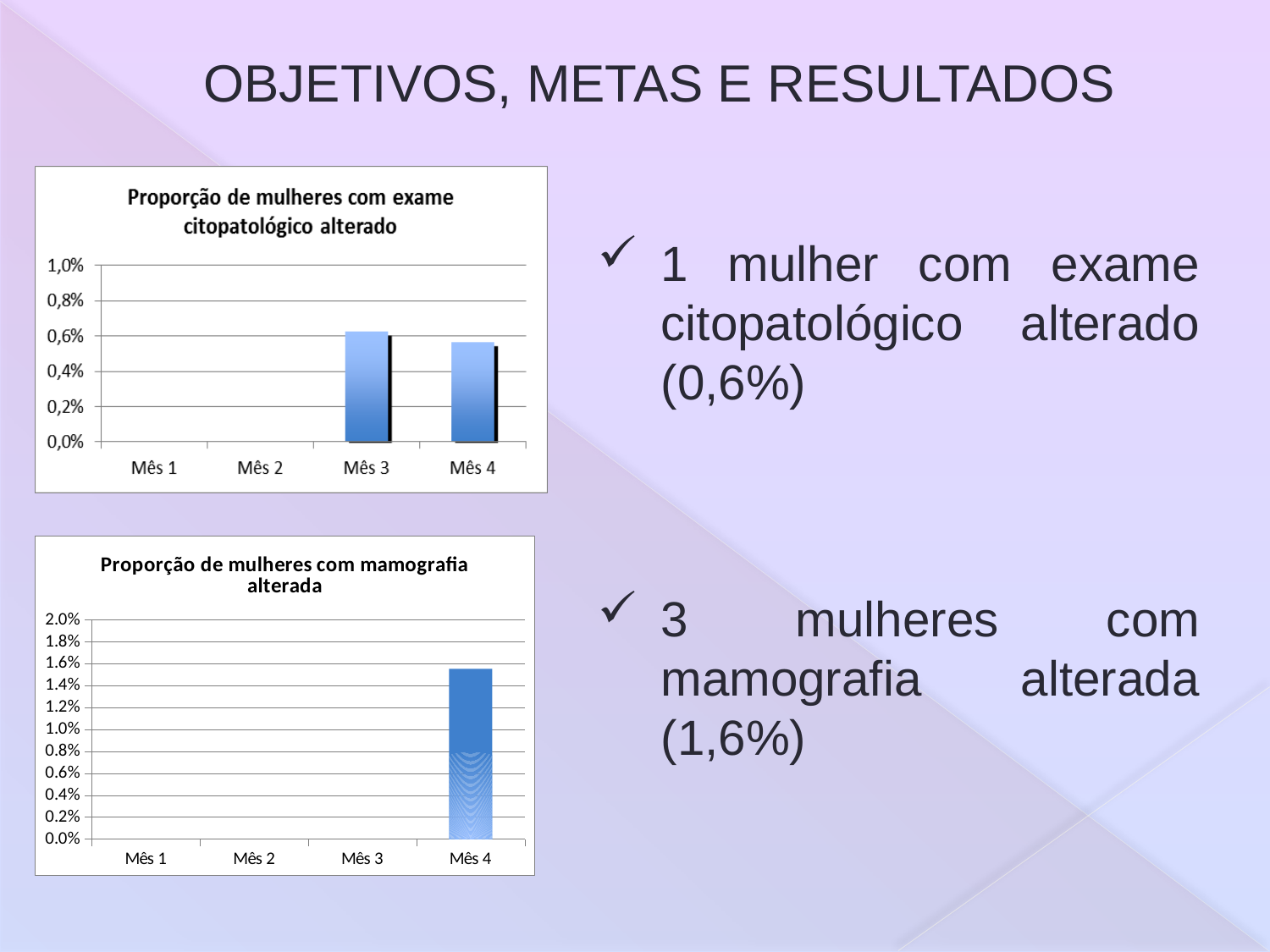
In the bottom chart (Proporção de mulheres com mamografia alterada), what is the highest value shown on the y axis? 2.0% In the bottom chart (Proporção de mulheres com mamografia alterada), which month has the highest value? Mês 4 In the bottom chart (Proporção de mulheres com mamografia alterada), is the value for Mês 4 greater or less than 2.0%? less In the top chart (Proporção de mulheres com exame citopatológico alterado), how many months are shown on the x axis? 4 In the top chart (Proporção de mulheres com exame citopatológico alterado), is the value for Mês 3 greater or less than 0,8%? less In the top chart (Proporção de mulheres com exame citopatológico alterado), which months have no visible bar? Mês 1 and Mês 2 In the bottom chart (Proporção de mulheres com mamografia alterada), is the value for Mês 4 greater or less than 1.0%? greater In the bottom chart (Proporção de mulheres com mamografia alterada), how many months are shown on the x axis? 4 What kind of chart is the bottom chart (Proporção de mulheres com mamografia alterada)? bar chart What kind of chart is the top chart (Proporção de mulheres com exame citopatológico alterado)? bar chart